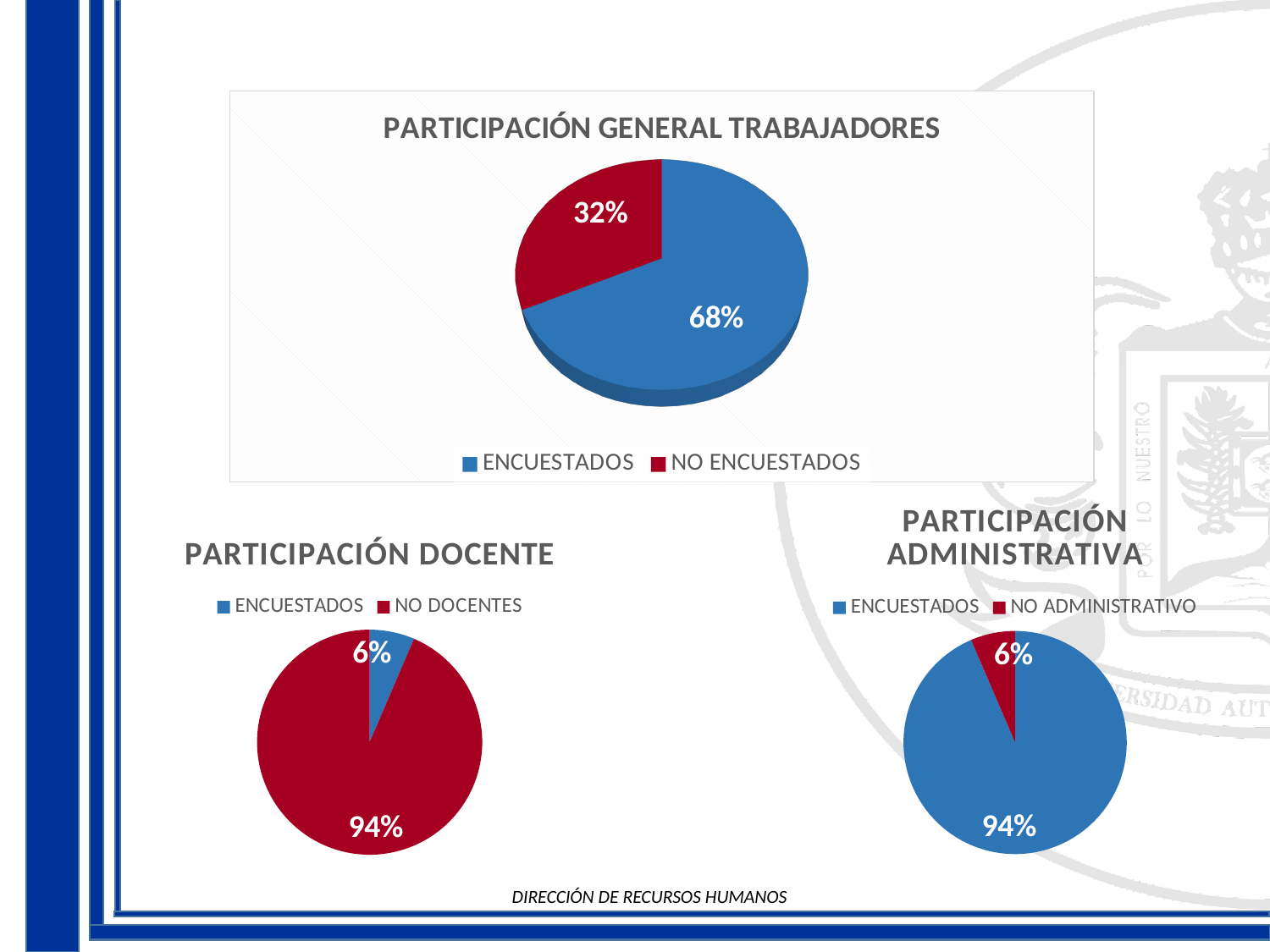
In the 'PARTICIPACIÓN DOCENTE' chart, which category is the smallest? ENCUESTADOS What kind of chart is 'PARTICIPACIÓN GENERAL TRABAJADORES'? Pie chart In the 'PARTICIPACIÓN ADMINISTRATIVA' chart, which is larger, ENCUESTADOS or NO ADMINISTRATIVO? ENCUESTADOS In the 'PARTICIPACIÓN GENERAL TRABAJADORES' chart, what is the value for NO ENCUESTADOS? 32% In the 'PARTICIPACIÓN DOCENTE' chart, what share of the pie is NO DOCENTES? 94% In the 'PARTICIPACIÓN ADMINISTRATIVA' chart, what is the value for ENCUESTADOS? 94% How many categories does the legend of the 'PARTICIPACIÓN ADMINISTRATIVA' chart list? 2 In the 'PARTICIPACIÓN GENERAL TRABAJADORES' chart, which category is the largest? ENCUESTADOS In the 'PARTICIPACIÓN GENERAL TRABAJADORES' chart, what share of the pie is ENCUESTADOS? 68% In the 'PARTICIPACIÓN GENERAL TRABAJADORES' chart, what is the difference between ENCUESTADOS and NO ENCUESTADOS? 36% In the 'PARTICIPACIÓN DOCENTE' chart, what is the value for ENCUESTADOS? 6% In the 'PARTICIPACIÓN DOCENTE' chart, what colour is the NO DOCENTES slice? Red